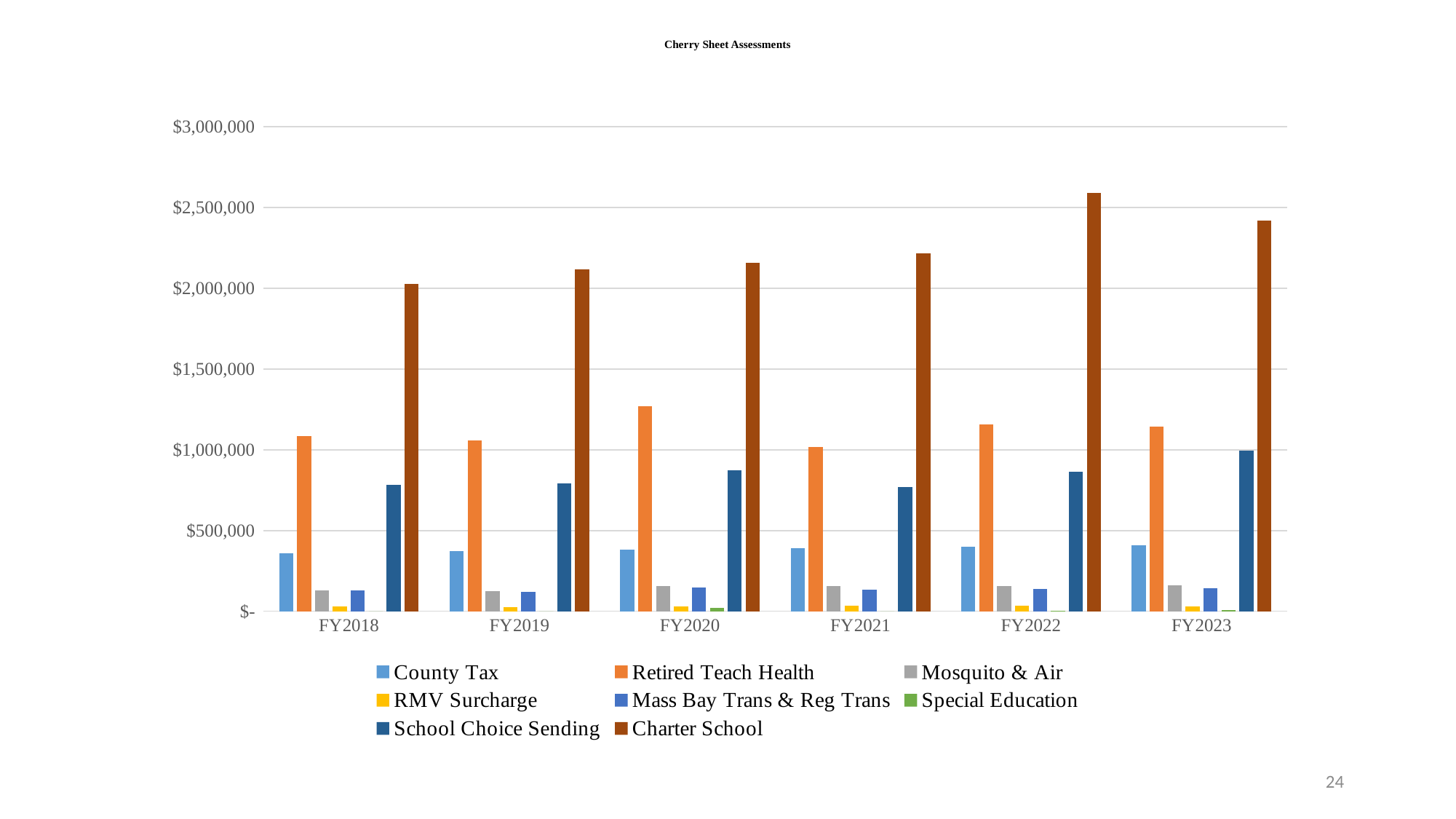
Does the Charter School assessment rise or fall from FY2018 to FY2022? rise What is the title of the chart? Cherry Sheet Assessments Is the Retired Teach Health value for FY2020 greater or less than $1,000,000? greater In which fiscal year is the Charter School assessment lowest? FY2018 What kind of chart is shown on the slide? bar chart How many fiscal years are shown on the x axis? 6 Is the County Tax value for FY2018 greater or less than $500,000? less In which fiscal year is the Charter School assessment highest? FY2022 In which fiscal year is the Retired Teach Health assessment highest? FY2020 Which is larger, the Retired Teach Health value for FY2020 or for FY2021? FY2020 Is the Charter School value for FY2022 greater or less than $2,500,000? greater How many series does the legend list? 8